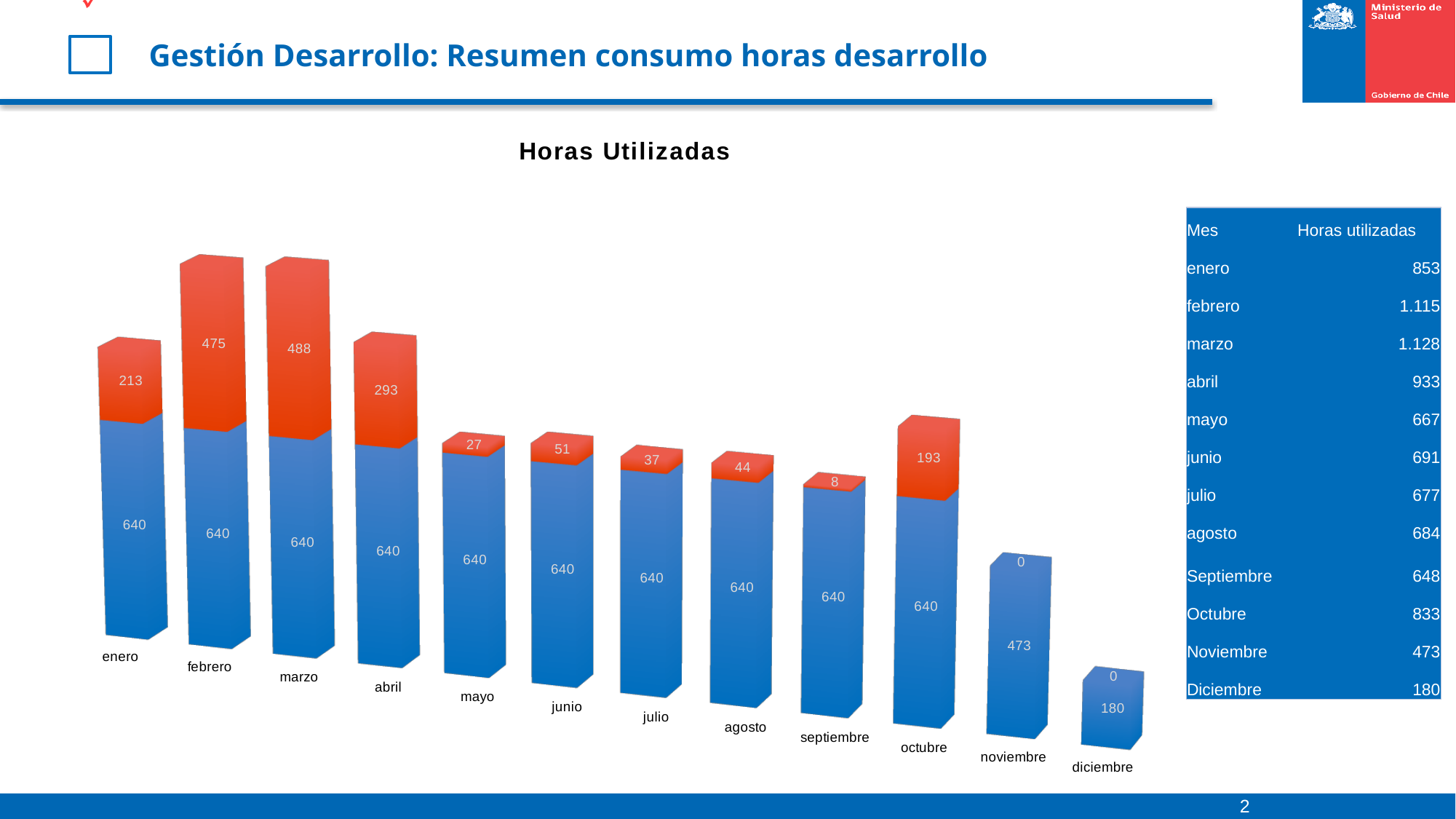
What is the value of the blue (lower) segment for noviembre? 473 What is the value of the red (upper) segment for septiembre? 8 What is the difference between the red segment values for febrero and abril? 182 How many months are plotted on the x axis of the "Horas Utilizadas" chart? 12 What is the total of the stacked bar for octubre? 833 Which month has the lowest blue (lower) segment value? diciembre Is the red segment value for junio larger or smaller than that for julio? larger Which month has the highest red (upper) segment value? marzo What type of chart is shown under the title "Horas Utilizadas"? Stacked bar chart What is the total of the stacked bar for enero? 853 What is the value of the red (upper) segment for marzo? 488 What is the title of the chart? Horas Utilizadas